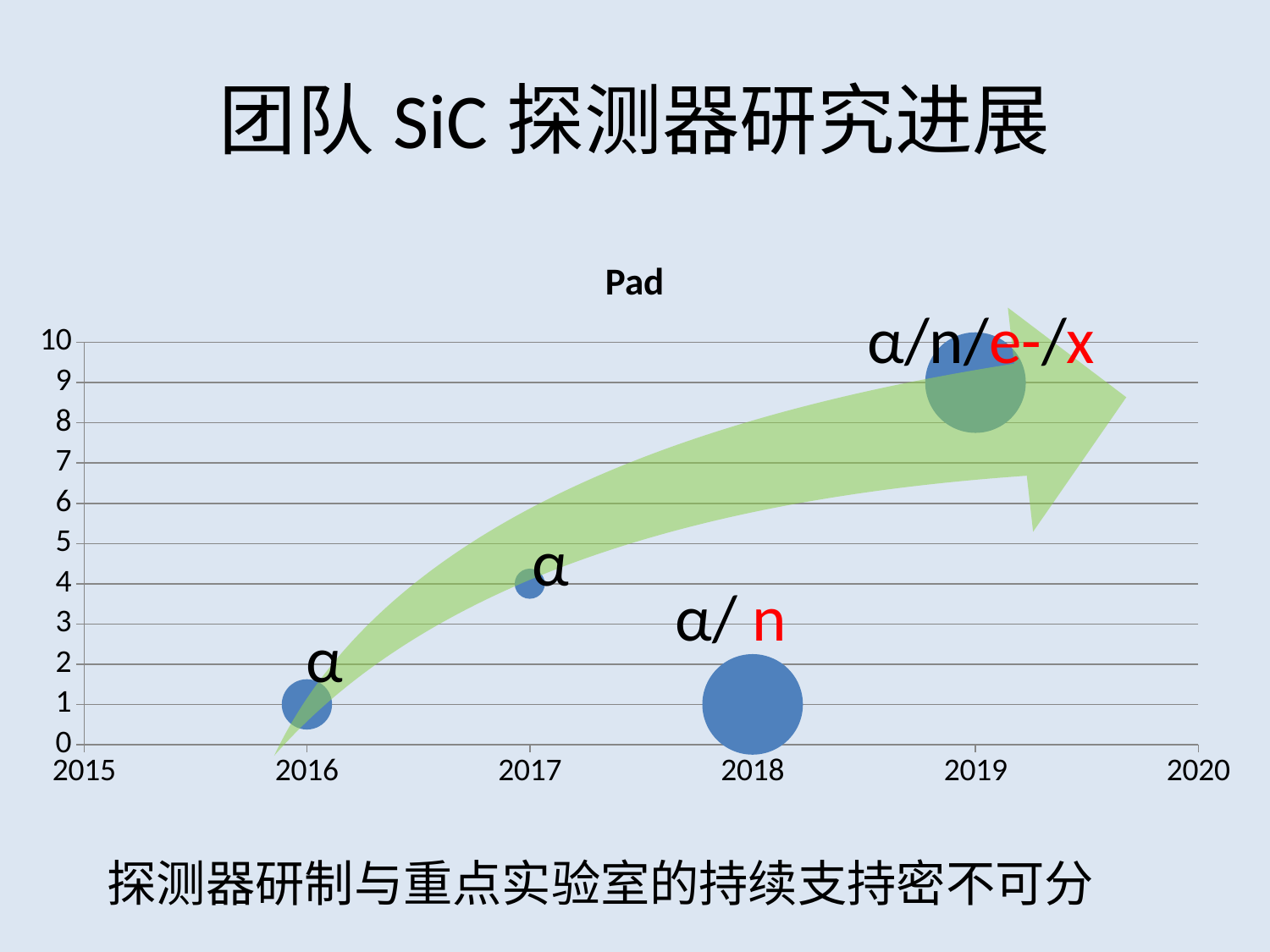
Is the value for 2019 greater or less than 8? greater What label is written next to the 2018 bubble? α/ n How many bubbles are plotted in the chart? 4 What kind of chart is shown on the slide? bubble chart Which is higher in the chart, the bubble for 2019 or the bubble for 2017? 2019 Is the value for 2017 greater or less than 3? greater Which year has the highest bubble in the chart? 2019 Does the value rise or fall from 2016 to 2017? rise Is the value for 2016 greater or less than 2? less What is the title of the chart? Pad Which is higher in the chart, the bubble for 2017 or the bubble for 2018? 2017